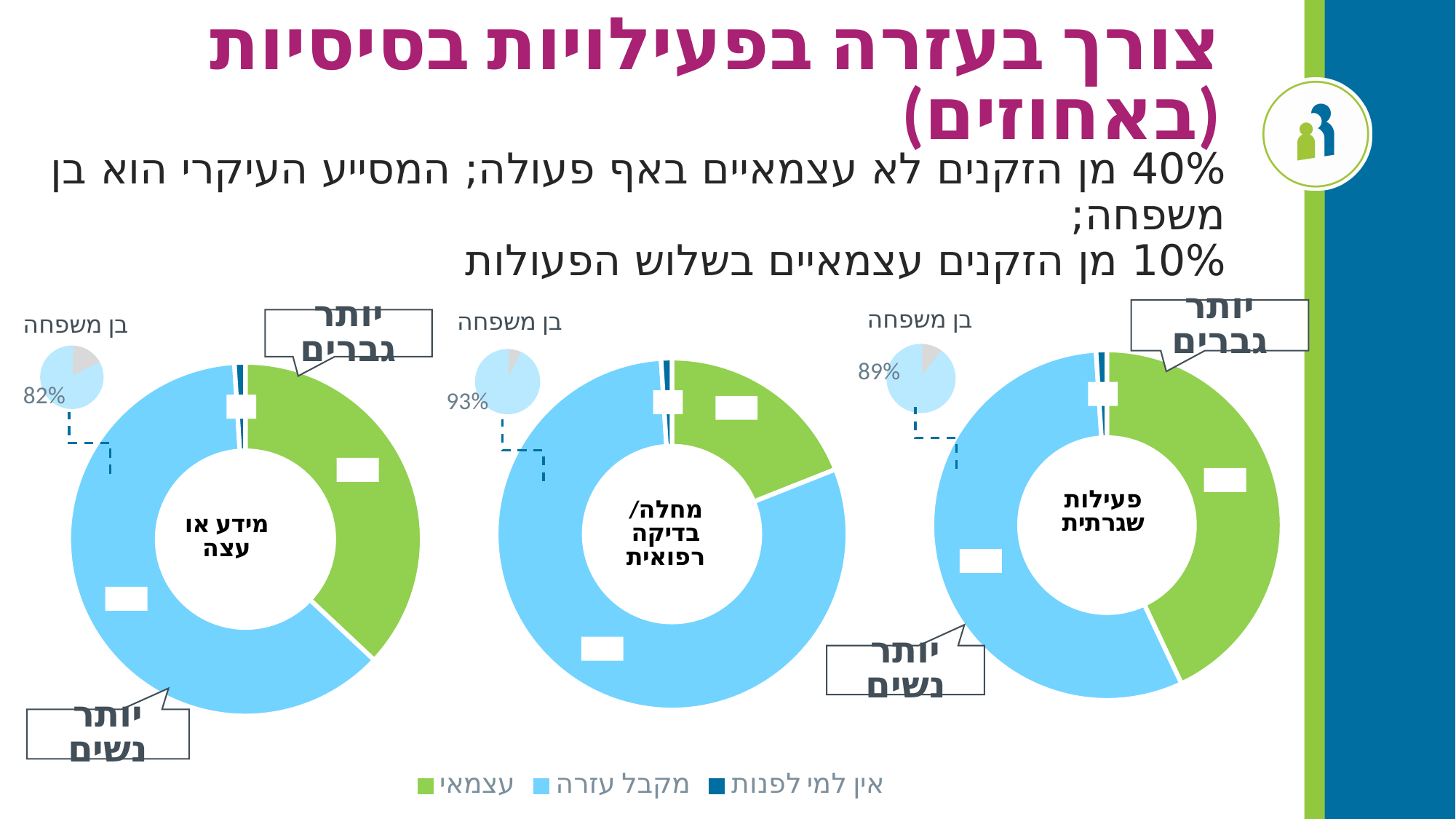
What kind of chart is used for the three main charts on the slide? Donut (pie) chart What percentage is shown in the small 'בן משפחה' pie next to the 'פעילות שגרתית' chart? 89% In the 'פעילות שגרתית' chart, which is larger: the 'מקבל עזרה' slice or the 'עצמאי' slice? מקבל עזרה In the 'מידע או עצה' chart, which is larger: the 'מקבל עזרה' slice or the 'עצמאי' slice? מקבל עזרה How many series does the legend at the bottom of the slide list? 3 What is the difference between the 'בן משפחה' percentages for 'מחלה/בדיקה רפואית' and 'מידע או עצה'? 11 percentage points What percentage is shown in the small 'בן משפחה' pie next to the 'מידע או עצה' chart? 82% Which of the three small 'בן משפחה' pies shows the highest percentage? מחלה/בדיקה רפואית (93%) In the 'מידע או עצה' chart, which category has the smallest slice? אין למי לפנות In the 'מחלה/בדיקה רפואית' chart, which is larger: the 'מקבל עזרה' slice or the 'עצמאי' slice? מקבל עזרה What percentage is shown in the small 'בן משפחה' pie next to the 'מחלה/בדיקה רפואית' chart? 93% How many main donut charts are shown on the slide? 3